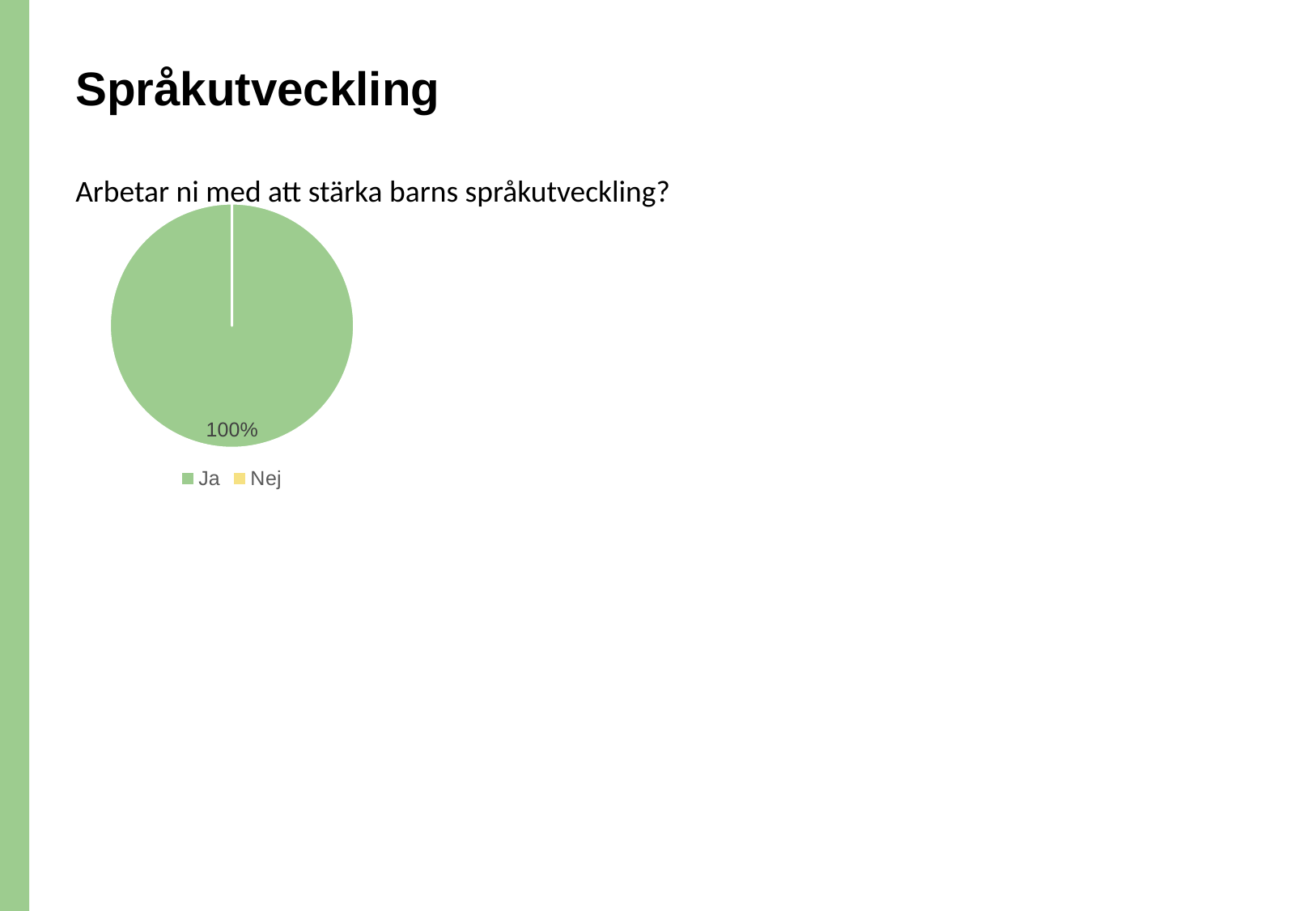
What colour represents "Ja" in the legend? green What kind of chart is shown on the slide? pie chart Which category has the largest share of the pie? Ja What share of the pie does "Ja" represent? 100% What is the only data label printed on the pie chart? 100% How many categories does the legend list? 2 Which is larger, the share for "Ja" or the share for "Nej"? Ja What question does the chart answer, as written above it? Arbetar ni med att stärka barns språkutveckling? Which category has the smallest share of the pie? Nej